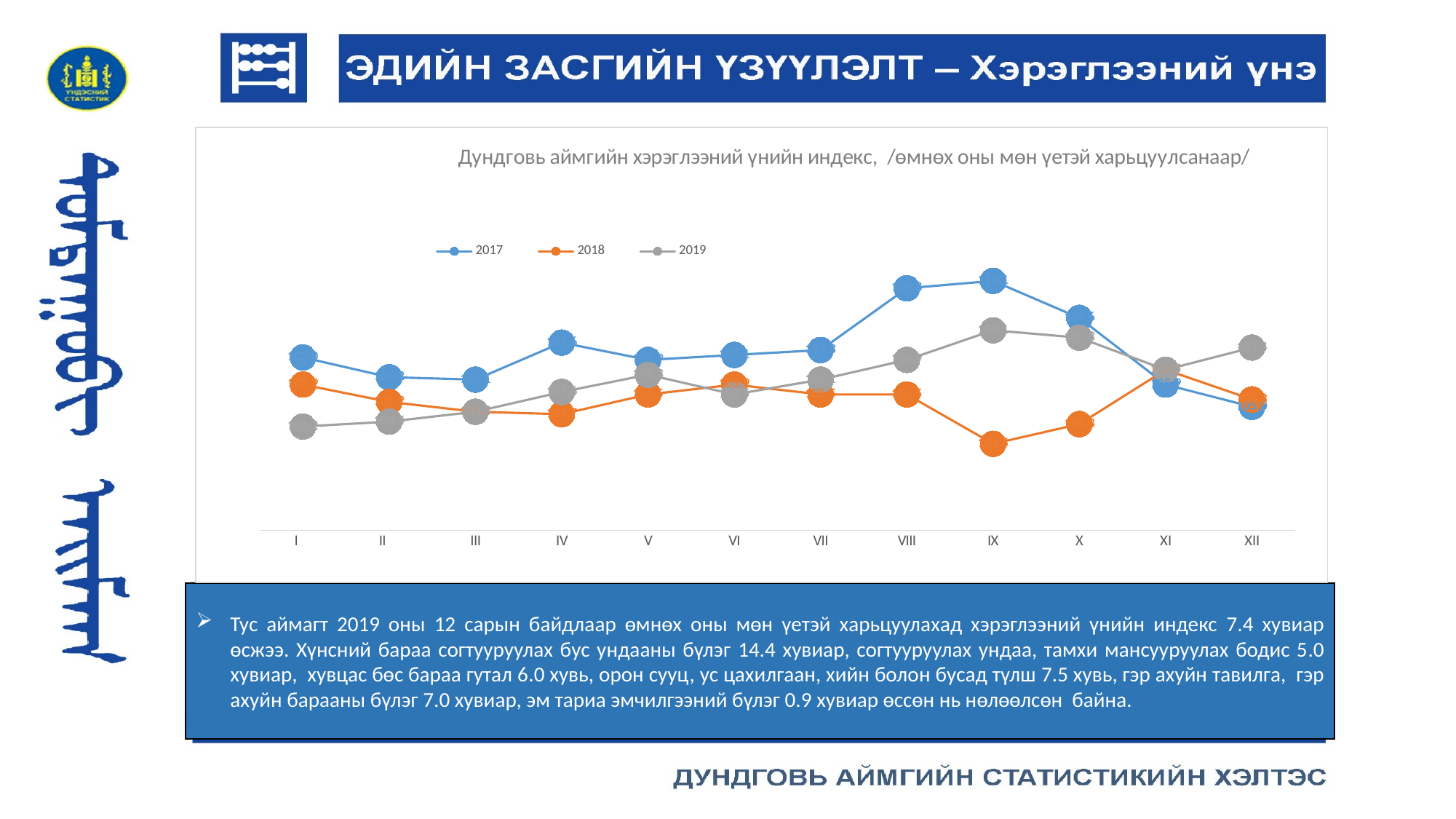
How many series does the legend list? 3 In month XII, which series has the higher value, 2017 or 2019? 2019 Which years are listed in the legend? 2017, 2018, 2019 How many points (months) are plotted along the x axis? 12 In which month does the 2017 series reach its lowest value? XII In month IX, which series has the higher value, 2017 or 2018? 2017 What kind of chart is shown on the slide? Line chart What is the title of the chart? Дундговь аймгийн хэрэглээний үнийн индекс, /өмнөх оны мөн үетэй харьцуулсанаар/ In which month does the 2018 series reach its lowest value? IX In which month does the 2017 series reach its highest value? IX Does the 2017 series rise or fall from month IX to month XII? Fall In which month does the 2019 series reach its lowest value? I